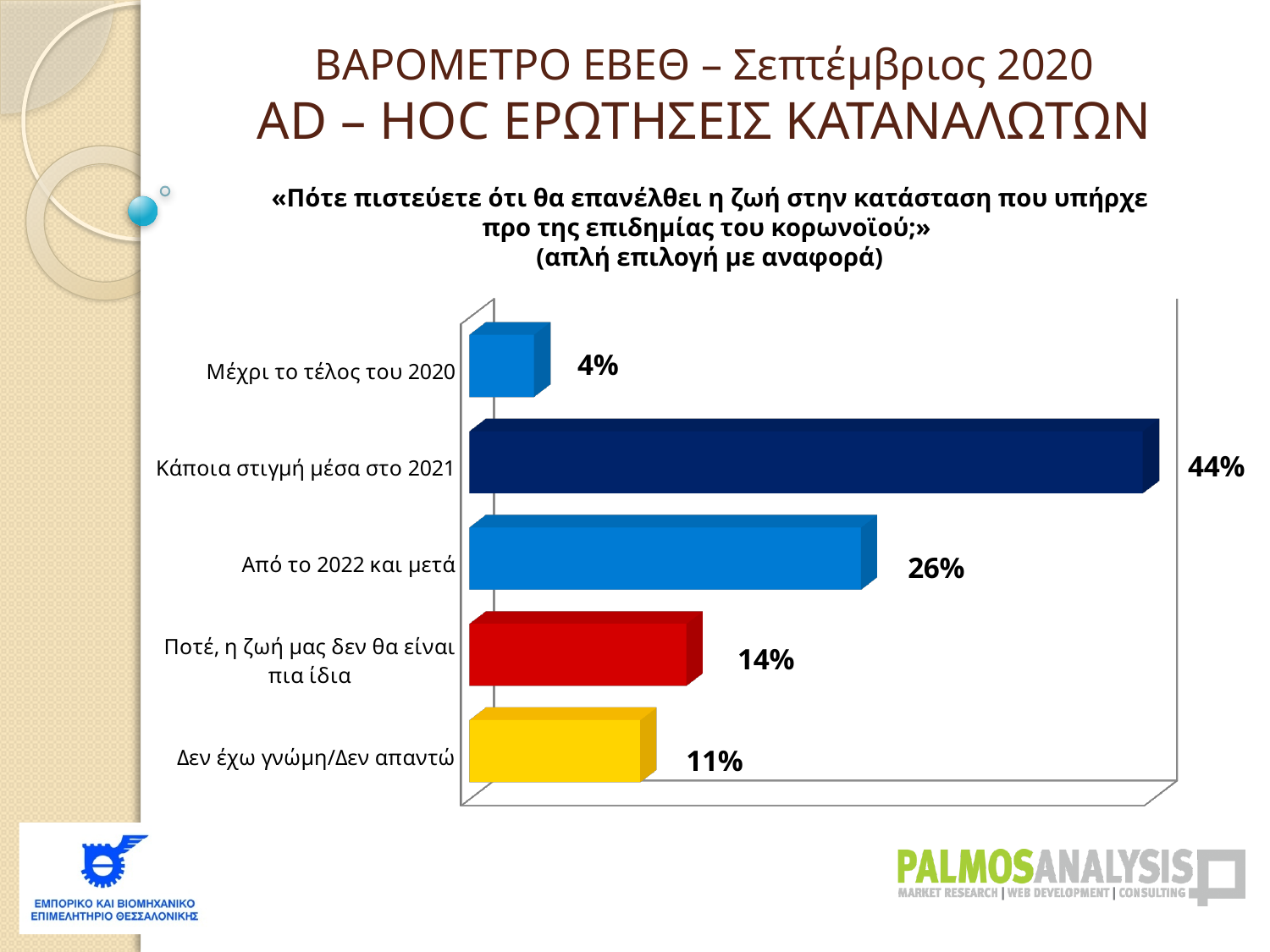
What is the value for "Δεν έχω γνώμη/Δεν απαντώ"? 11% Which is larger, the value for "Ποτέ, η ζωή μας δεν θα είναι πια ίδια" or the value for "Δεν έχω γνώμη/Δεν απαντώ"? Ποτέ, η ζωή μας δεν θα είναι πια ίδια What is the value for "Μέχρι το τέλος του 2020"? 4% What is the value for "Ποτέ, η ζωή μας δεν θα είναι πια ίδια"? 14% What colour is the bar for "Ποτέ, η ζωή μας δεν θα είναι πια ίδια"? Red How many categories are shown in the chart? 5 What is the difference between the values for "Κάποια στιγμή μέσα στο 2021" and "Από το 2022 και μετά"? 18% Which category has the lowest value? Μέχρι το τέλος του 2020 What is the value for "Κάποια στιγμή μέσα στο 2021"? 44% What is the value for "Από το 2022 και μετά"? 26% Which category has the highest value? Κάποια στιγμή μέσα στο 2021 What kind of chart is shown on the slide? Bar chart